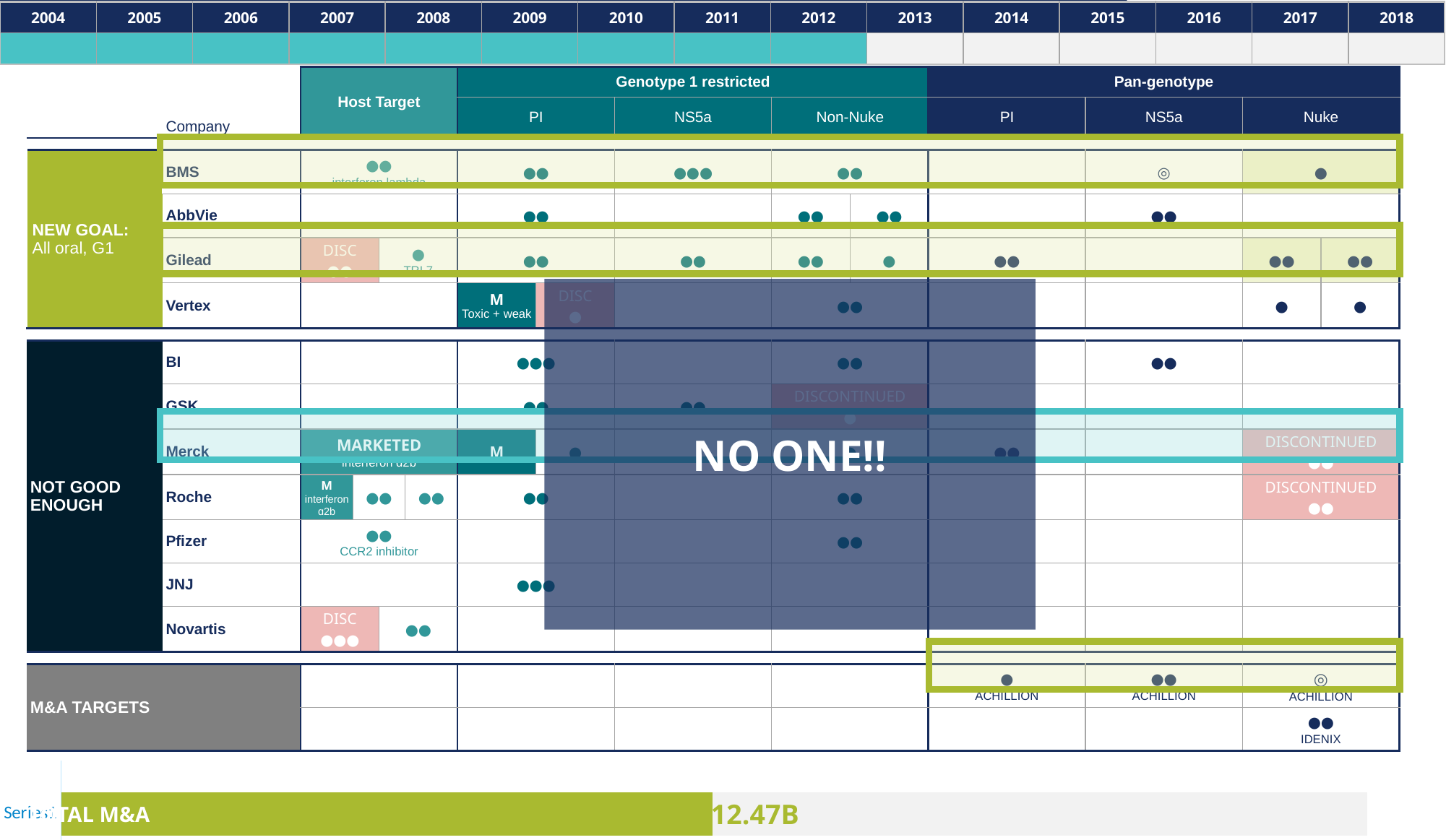
What kind of chart is shown at the bottom of the slide? bar chart What colour is the bar in the chart at the bottom of the slide? green On the bar chart at the bottom of the slide, what value is shown for TOTAL M&A? 12.47B How many bars does the chart at the bottom of the slide show? 1